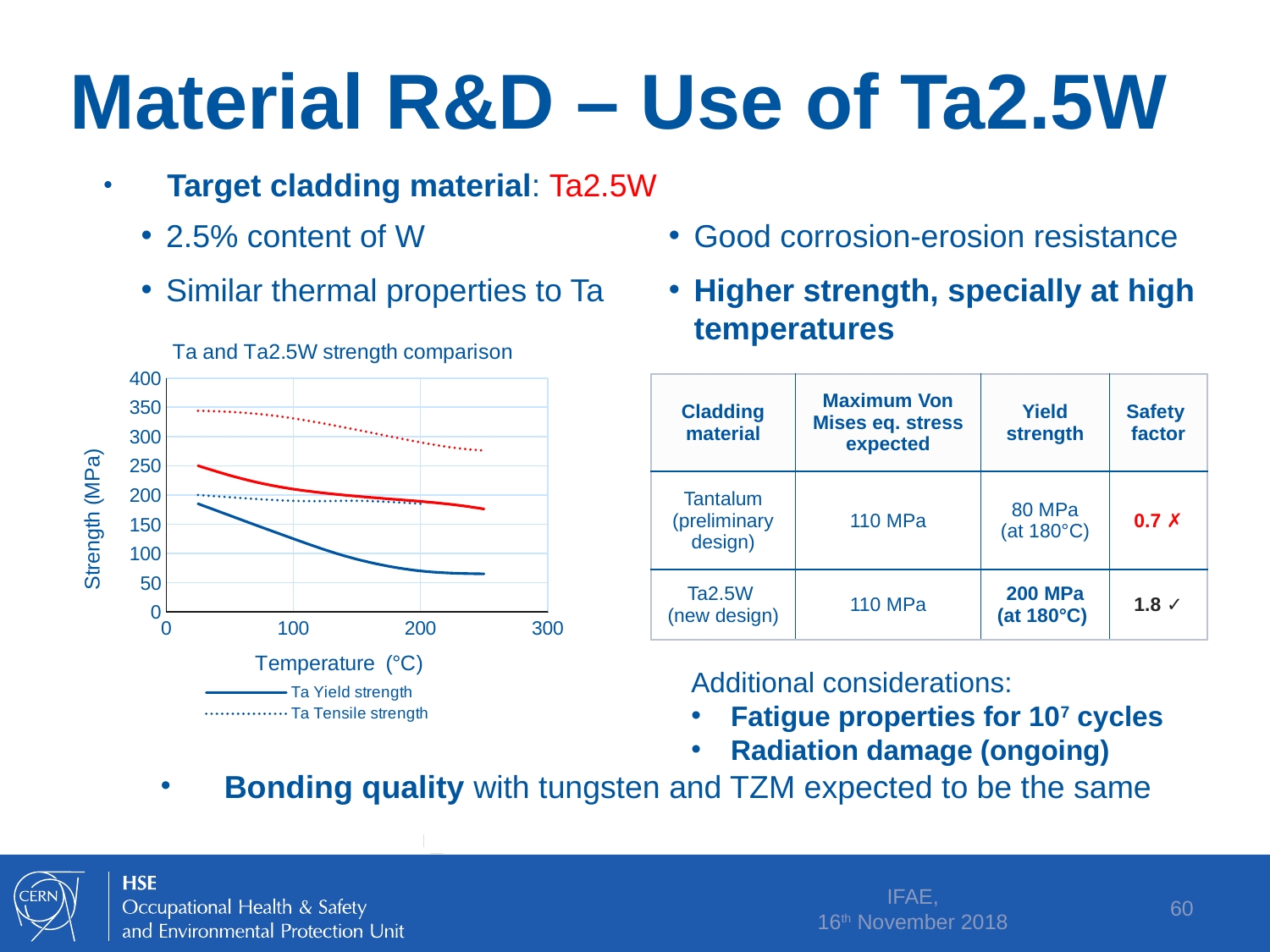
At 100°C, which is larger: Ta Tensile strength or Ta Yield strength? Ta Tensile strength What is the title of the chart? Ta and Ta2.5W strength comparison Is the Ta Yield strength at 200°C greater or less than 100 MPa? less Is the Ta Yield strength at 250°C greater or less than 100 MPa? less Does the Ta Yield strength rise or fall as temperature increases? fall How many series does the chart's legend list? 2 How many lines are plotted on the chart? 4 Is the Ta Tensile strength at 100°C greater or less than 150 MPa? greater What kind of chart is shown on the slide? line chart What is the label of the chart's y axis? Strength (MPa)